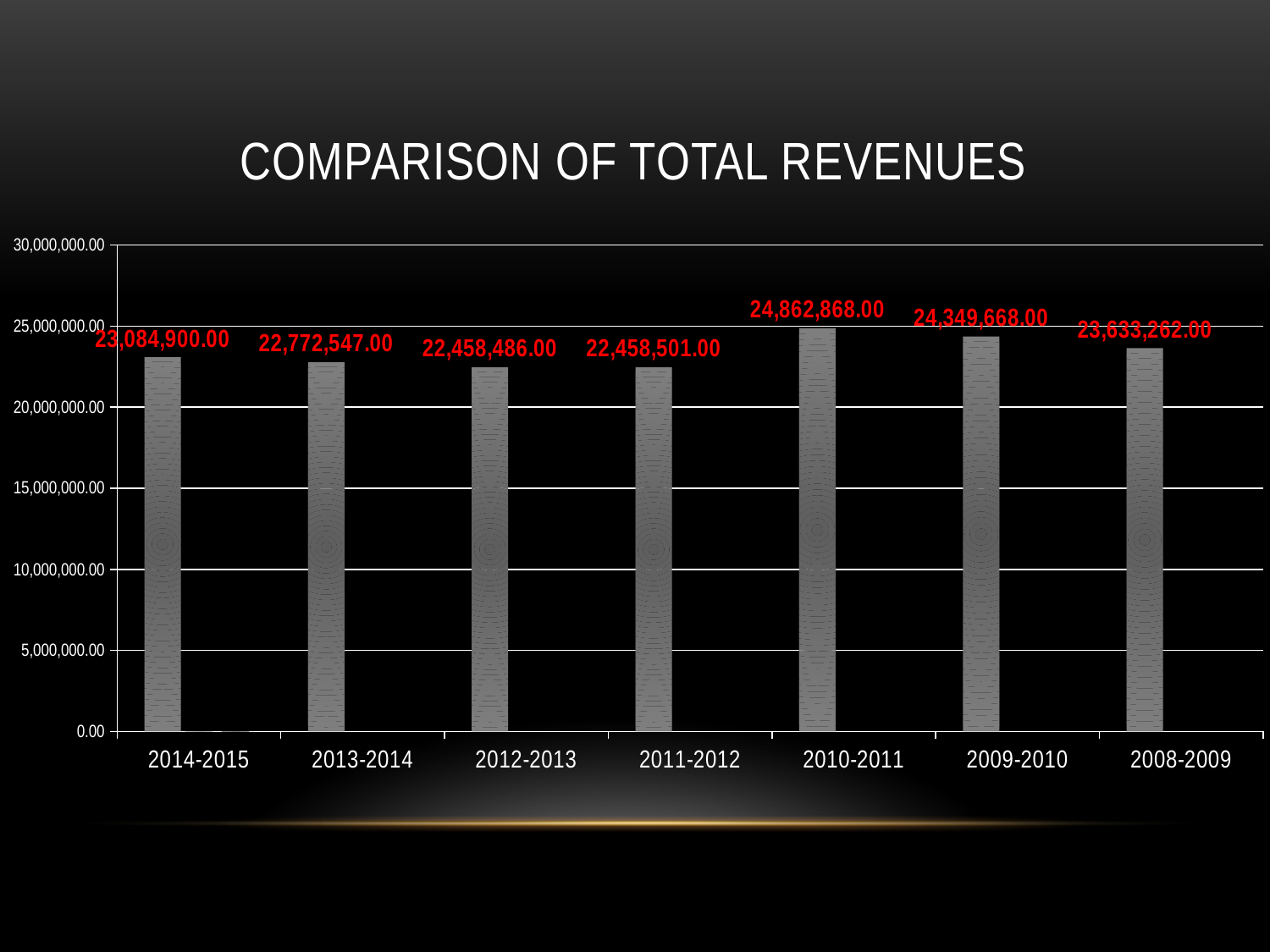
What is the total revenue shown for 2013-2014? 22,772,547.00 How many years are shown on the chart? 7 What is the total revenue shown for 2010-2011? 24,862,868.00 Which is larger, the total revenue for 2009-2010 or for 2013-2014? 2009-2010 What is the total revenue shown for 2008-2009? 23,633,262.00 What kind of chart is shown on the slide? bar chart What is the difference between the total revenues for 2010-2011 and 2014-2015? 1,777,968.00 What is the title of the chart? COMPARISON OF TOTAL REVENUES Which year has the highest total revenue? 2010-2011 What is the difference between the total revenues for 2009-2010 and 2008-2009? 716,406.00 What is the total revenue shown for 2014-2015? 23,084,900.00 Is the value for 2013-2014 greater or less than 25,000,000.00? less